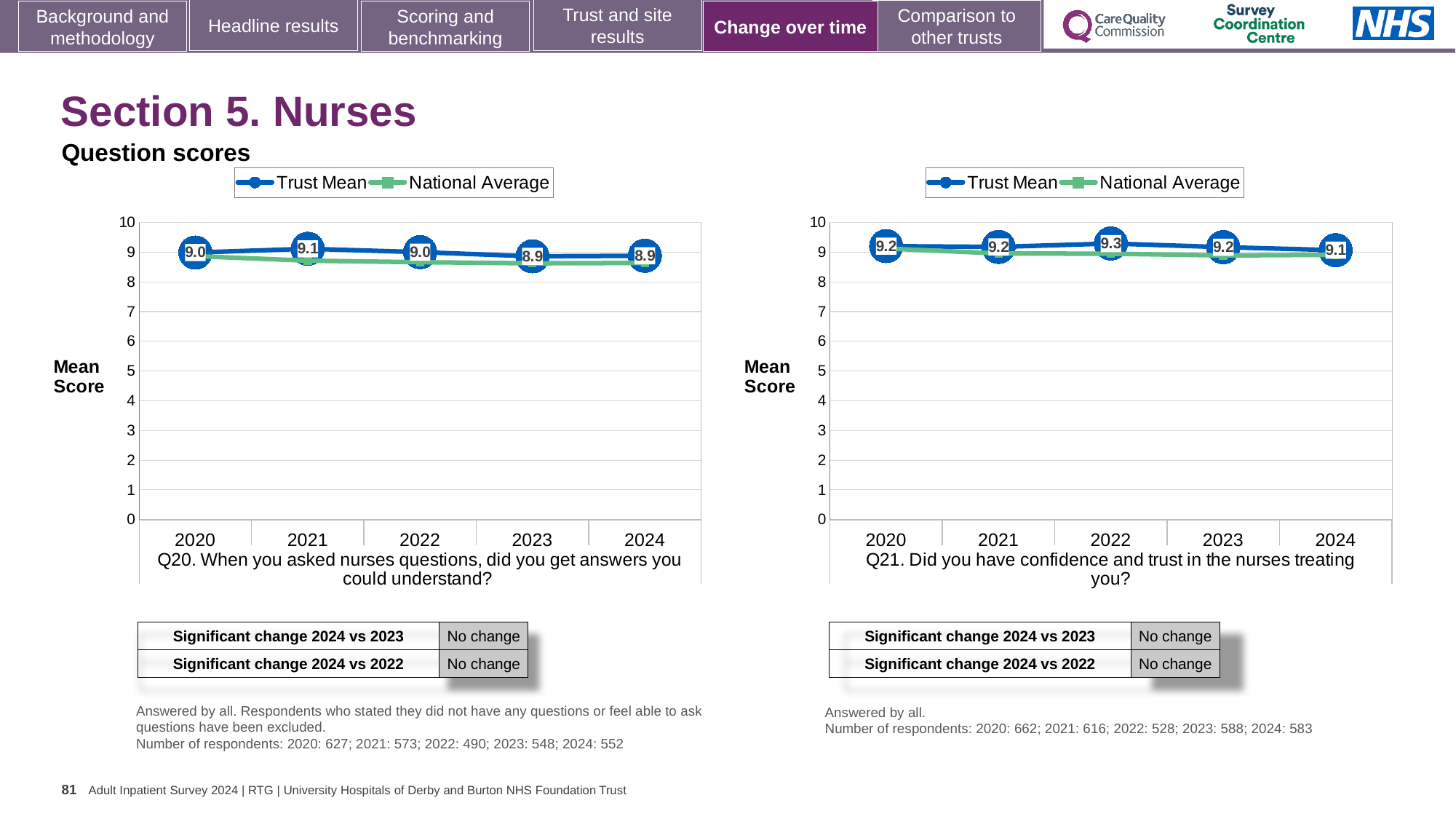
In the Q20 chart on the left, what is the Trust Mean score for 2021? 9.1 How many years are plotted on the x axis of the Q21 chart on the right? 5 In the Q20 chart on the left, what is the lowest Trust Mean score shown? 8.9 In the Q20 chart on the left, what is the difference between the Trust Mean scores for 2021 and 2024? 0.2 In the Q21 chart on the right, does the Trust Mean score rise or fall from 2022 to 2024? fall In the Q21 chart on the right, is the Trust Mean score for 2022 larger or smaller than the score for 2024? larger In the Q21 chart on the right, which year has the highest Trust Mean score? 2022 In the Q21 chart on the right, what is the Trust Mean score for 2024? 9.1 In the Q20 chart on the left, is the National Average value for 2024 greater or less than 8? greater How many series does the legend of the Q20 chart on the left list? 2 What type of chart is used for Q20 on the left? Line chart What is the y-axis label on the Q20 chart on the left? Mean Score